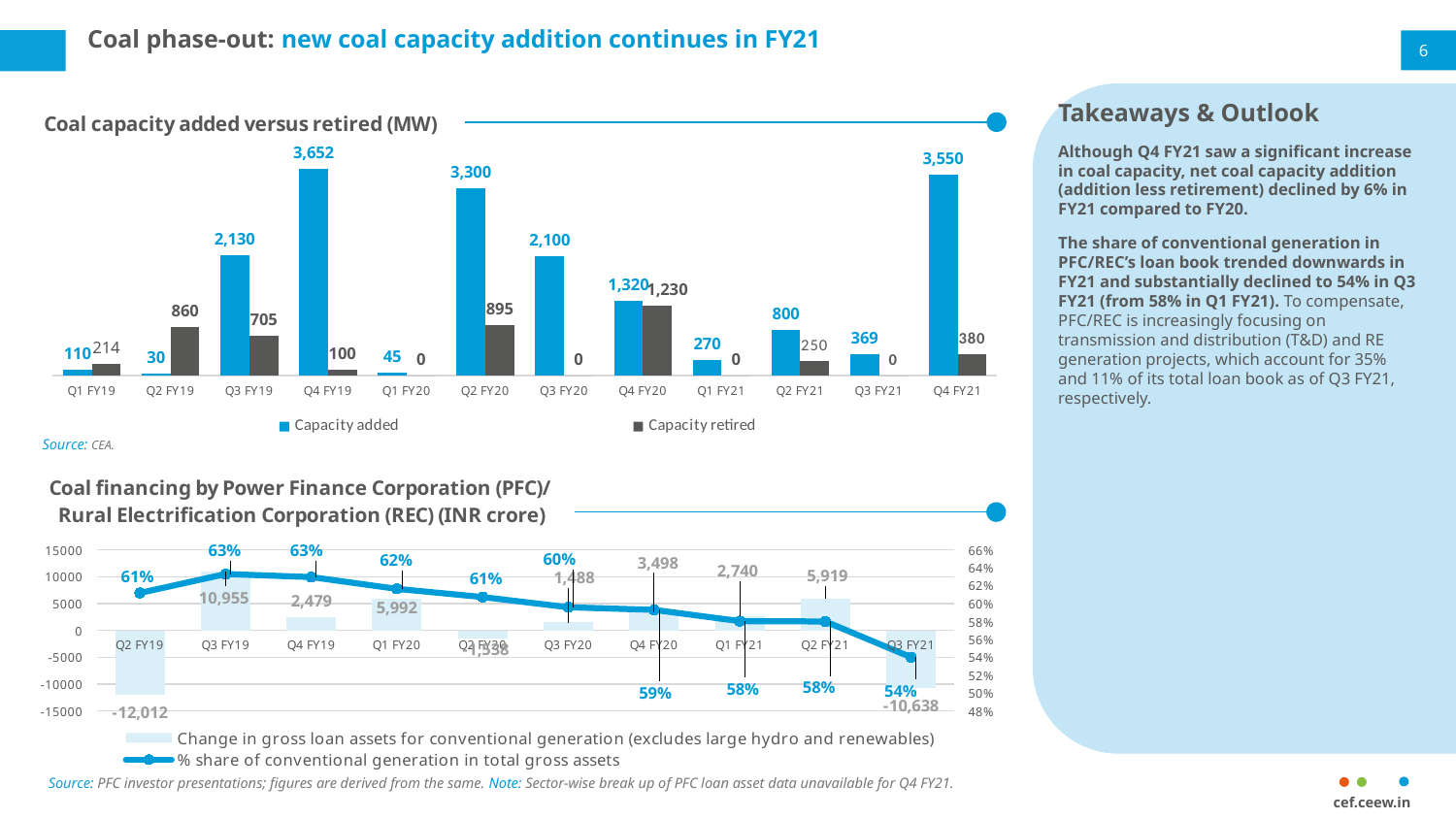
In the 'Coal capacity added versus retired (MW)' chart, what is the difference between capacity added and capacity retired in Q4 FY21? 3,170 In the 'Coal financing by PFC/REC (INR crore)' chart, what is the change in gross loan assets for conventional generation in Q3 FY19? 10,955 How many quarters are shown on the x axis of the 'Coal capacity added versus retired (MW)' chart? 12 In the 'Coal capacity added versus retired (MW)' chart, what is the capacity retired in Q4 FY20? 1,230 In the 'Coal financing by PFC/REC (INR crore)' chart, what is the % share of conventional generation in total gross assets in Q3 FY21? 54% In the 'Coal capacity added versus retired (MW)' chart, which quarter has the lowest capacity added? Q2 FY19 In the 'Coal capacity added versus retired (MW)' chart, which quarter has the highest capacity added? Q4 FY19 What kind of chart is the 'Coal capacity added versus retired (MW)' chart? Bar chart In the 'Coal capacity added versus retired (MW)' chart, which is larger in Q2 FY19: capacity added or capacity retired? Capacity retired In the 'Coal capacity added versus retired (MW)' chart, what is the capacity added in Q4 FY19? 3,652 In the 'Coal financing by PFC/REC (INR crore)' chart, does the % share of conventional generation rise or fall from Q4 FY19 to Q3 FY21? Fall How many series does the legend of the 'Coal capacity added versus retired (MW)' chart list? 2